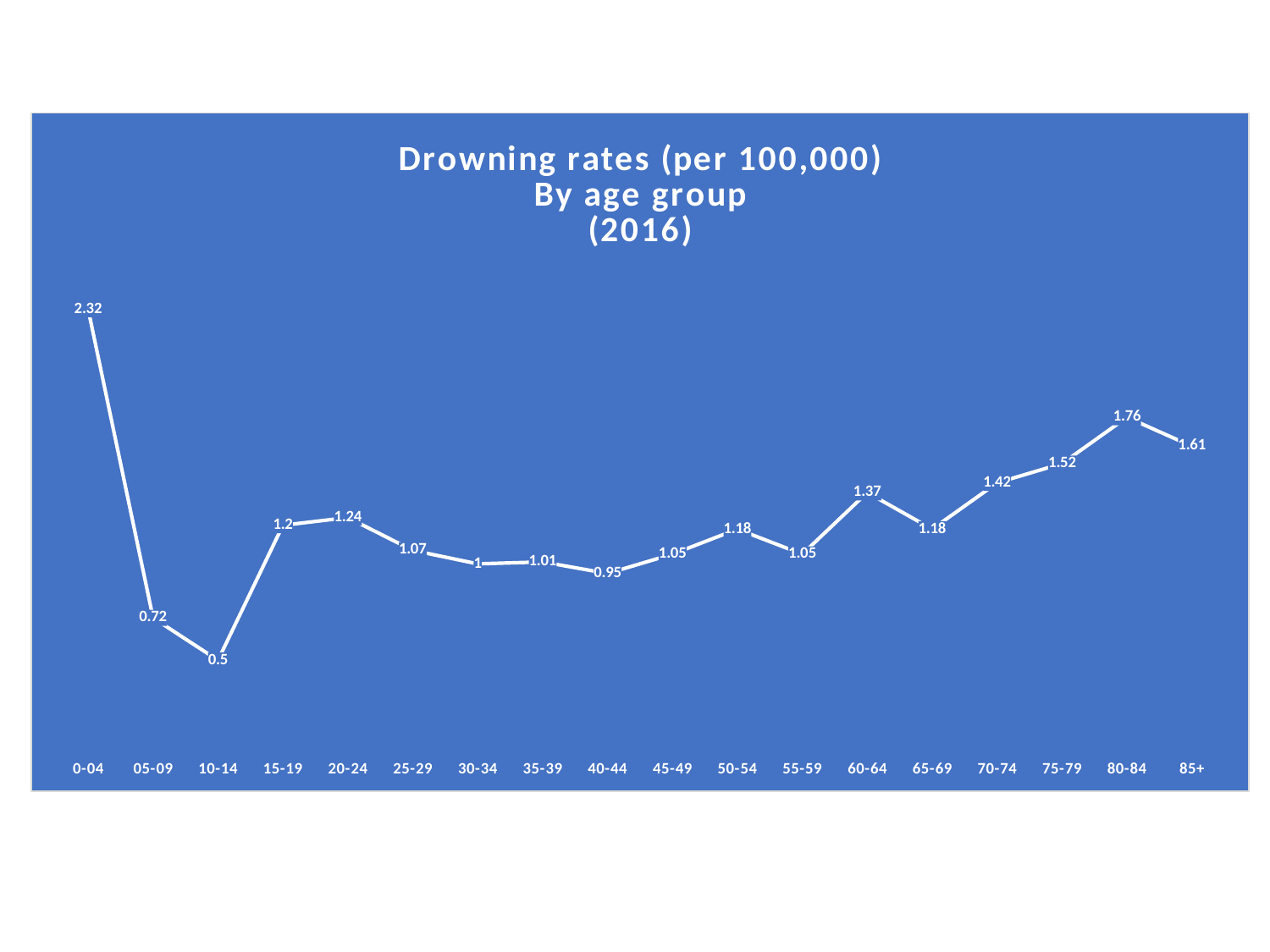
How many age groups are plotted on the chart? 18 Which age group has the lowest drowning rate? 10-14 What is the drowning rate for the 10-14 age group? 0.5 Do the drowning rates rise or fall from the 65-69 age group to the 80-84 age group? Rise What is the difference between the drowning rates for the 80-84 and 85+ age groups? 0.15 What is the drowning rate for the 85+ age group? 1.61 What is the drowning rate for the 0-04 age group? 2.32 What kind of chart is shown on the slide? Line chart What is the difference between the drowning rates for the 0-04 and 05-09 age groups? 1.6 Which age group has the highest drowning rate? 0-04 Which age group has a higher drowning rate, 60-64 or 65-69? 60-64 What is the drowning rate for the 80-84 age group? 1.76